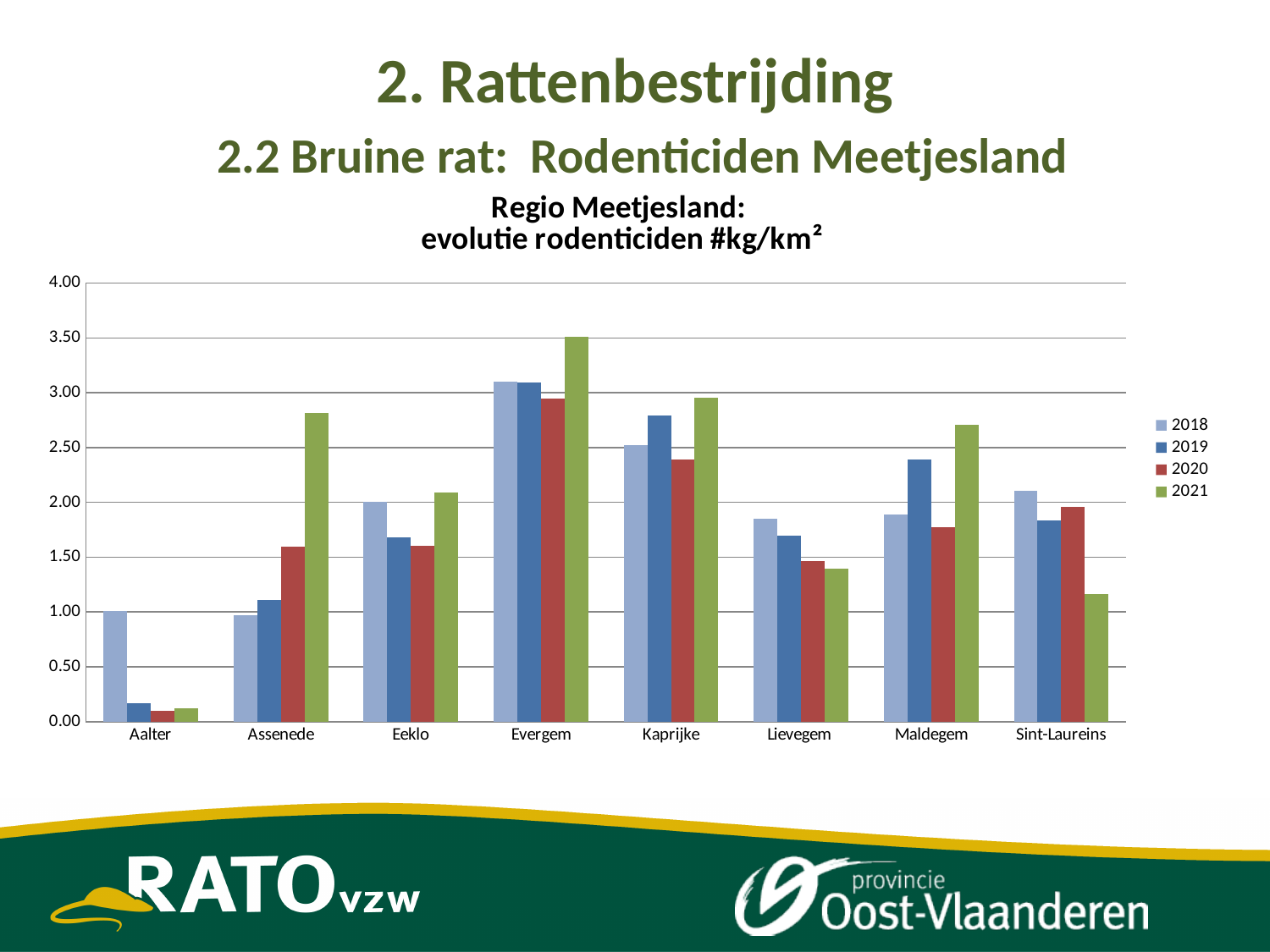
Do the values for Assenede rise or fall from 2018 to 2021? rise What kind of chart is shown on the slide? bar chart Which municipality has the lowest value for 2021? Aalter How many municipalities are shown on the x axis? 8 Which municipality has the highest value for 2021? Evergem How many series does the legend list? 4 For Maldegem, which year has the larger value, 2019 or 2020? 2019 Do the values for Lievegem rise or fall from 2018 to 2021? fall Is the value for Sint-Laureins in 2021 greater or less than 1.50? less Which years are listed in the legend? 2018, 2019, 2020, 2021 Is the value for Assenede in 2021 greater or less than 2.50? greater Is the value for Kaprijke in 2019 greater or less than 2.50? greater